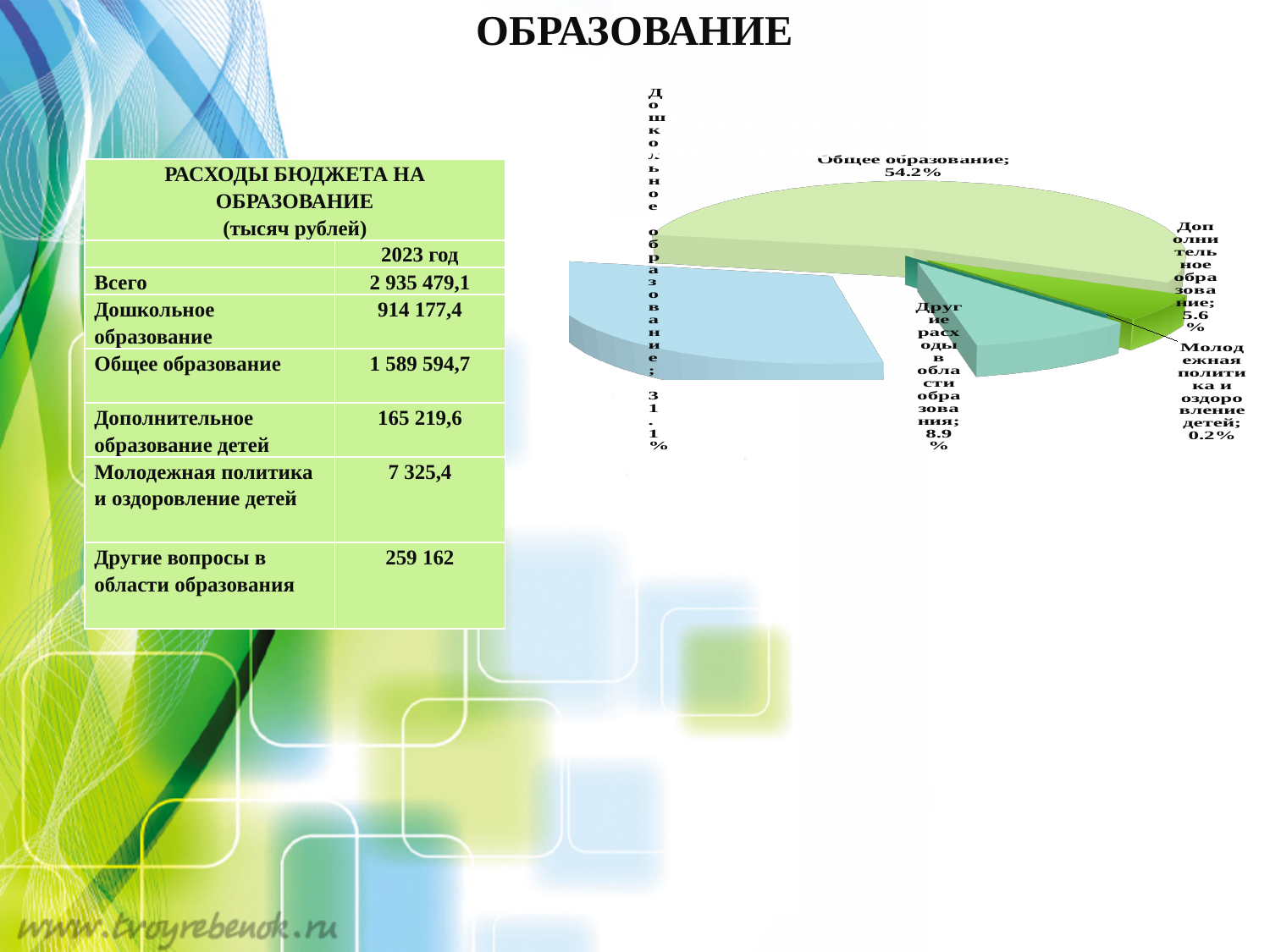
What is the combined share of the Дошкольное образование and Общее образование slices? 85.3% What share of the pie does Дополнительное образование have? 5.6% Which slice is larger: Дополнительное образование or Другие расходы в области образования? Другие расходы в области образования Which slice of the pie chart is the smallest? Молодежная политика и оздоровление детей What share of the pie does Молодежная политика и оздоровление детей have? 0.2% What share of the pie does Другие расходы в области образования have? 8.9% What kind of chart is shown on the slide? pie chart Which slice of the pie chart is the largest? Общее образование What is the difference in percentage points between the Общее образование slice and the Дошкольное образование slice? 23.1 How many slices does the pie chart have? 5